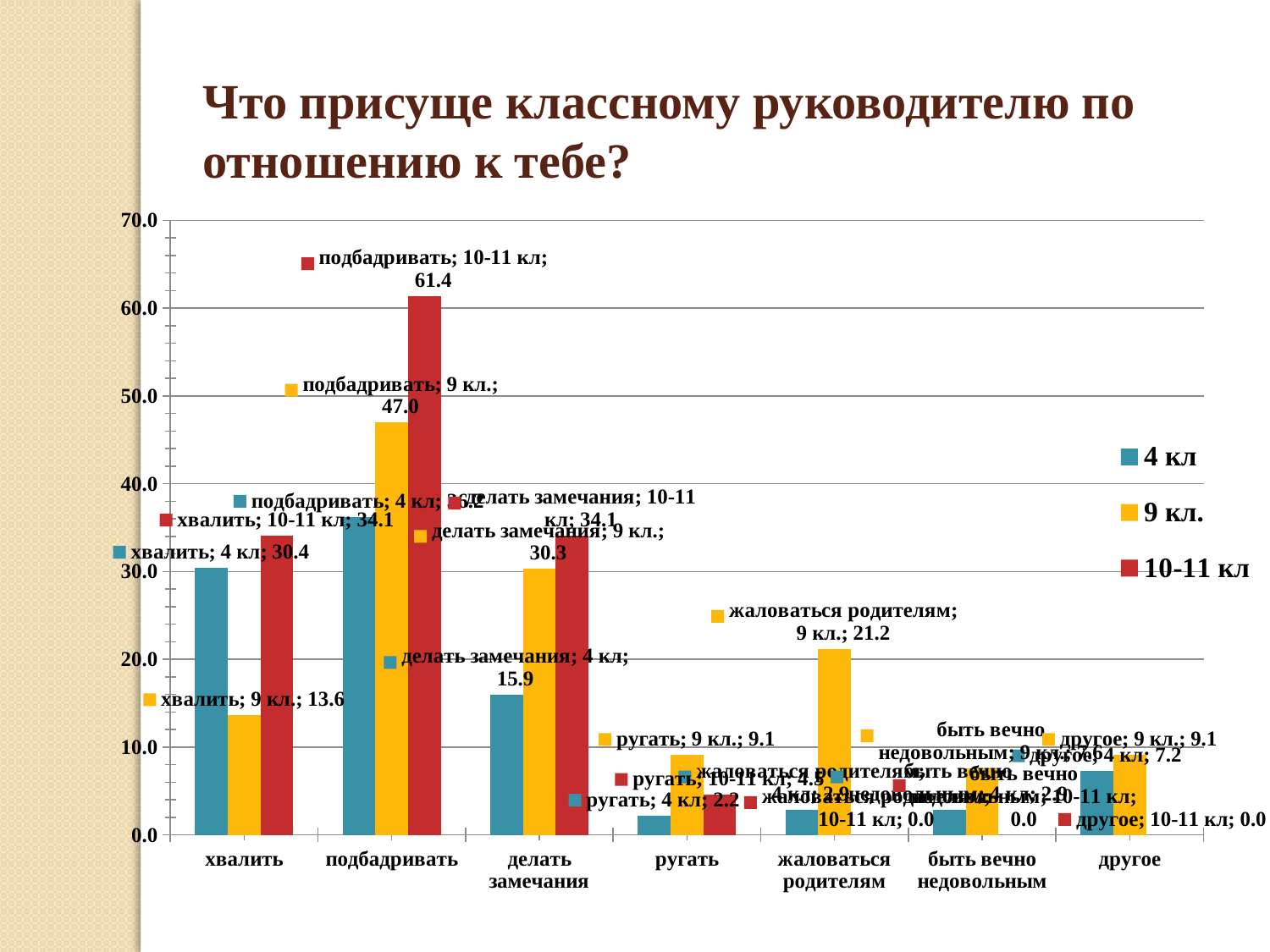
What is the value for 4 кл in the хвалить category? 30.4 Which category has the highest value for the 10-11 кл series? подбадривать How many categories are shown on the x axis? 7 How many series does the legend list? 3 What kind of chart is shown on the slide? bar chart What is the difference between the 10-11 кл and 9 кл. values in the подбадривать category? 14.4 What is the value for 9 кл. in the подбадривать category? 47.0 In the хвалить category, which series has the larger value: 4 кл or 9 кл.? 4 кл What is the value for 10-11 кл in the подбадривать category? 61.4 What is the value for 10-11 кл in the другое category? 0.0 What is the value for 9 кл. in the жаловаться родителям category? 21.2 Is the value for 4 кл in the подбадривать category greater or less than 30.0? greater